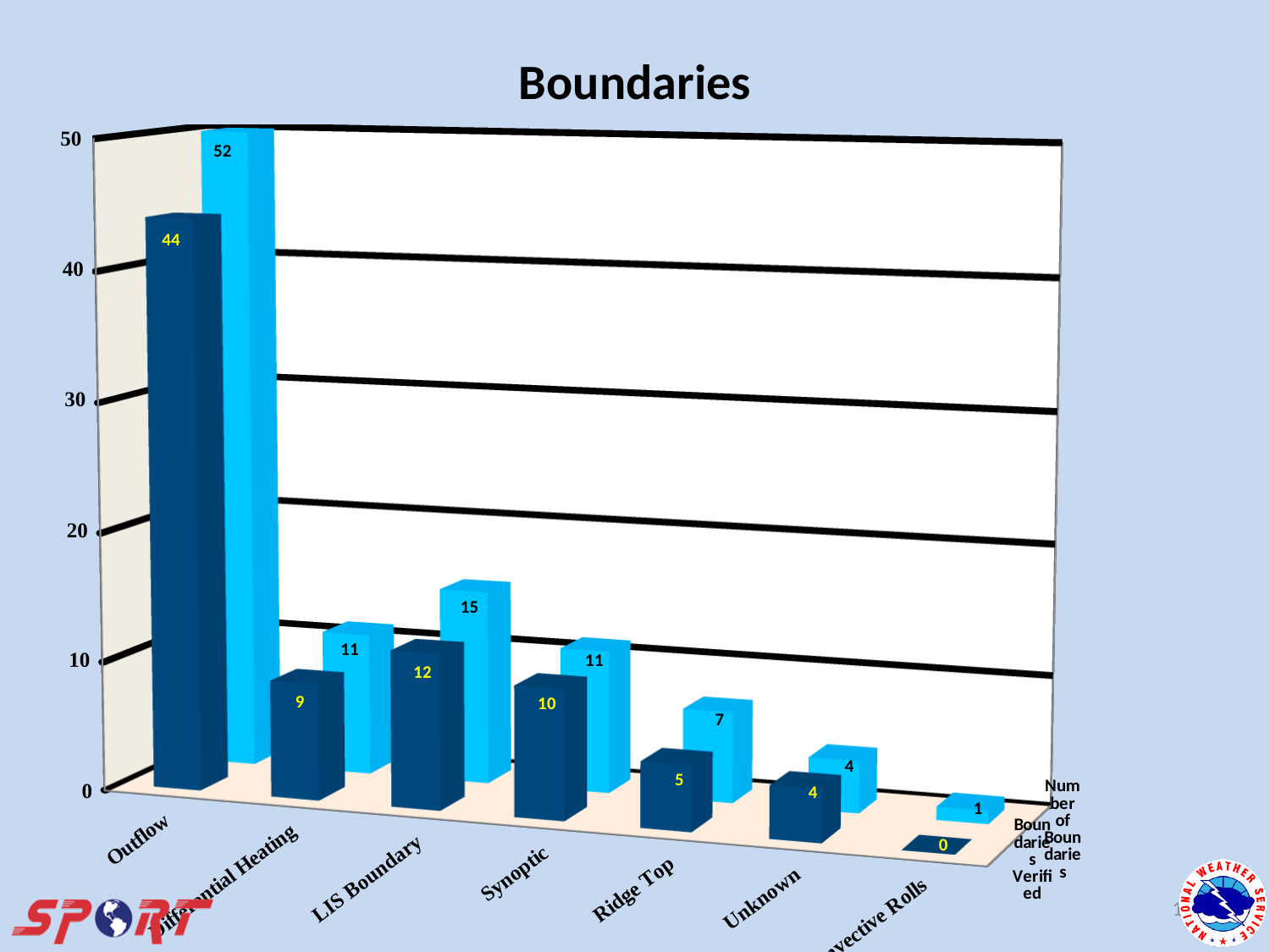
What is the Boundaries Verified (dark blue bar) value for Outflow? 44 What is the title of the chart? Boundaries Is the Boundaries Verified (dark blue bar) value for Outflow greater or less than 40? greater What type of chart is shown on the slide? bar chart Which category has the highest Number of Boundaries (light blue bar)? Outflow Which category has the lowest Boundaries Verified (dark blue bar) value? Convective Rolls What is the Boundaries Verified (dark blue bar) value for Synoptic? 10 What is the difference between the Number of Boundaries and Boundaries Verified values for Outflow? 8 How many categories are shown along the x axis of the chart? 7 What is the Number of Boundaries (light blue bar) value for LIS Boundary? 15 Which is larger for Ridge Top: the light blue bar (Number of Boundaries) or the dark blue bar (Boundaries Verified)? Number of Boundaries What is the Number of Boundaries (light blue bar) value for Outflow? 52